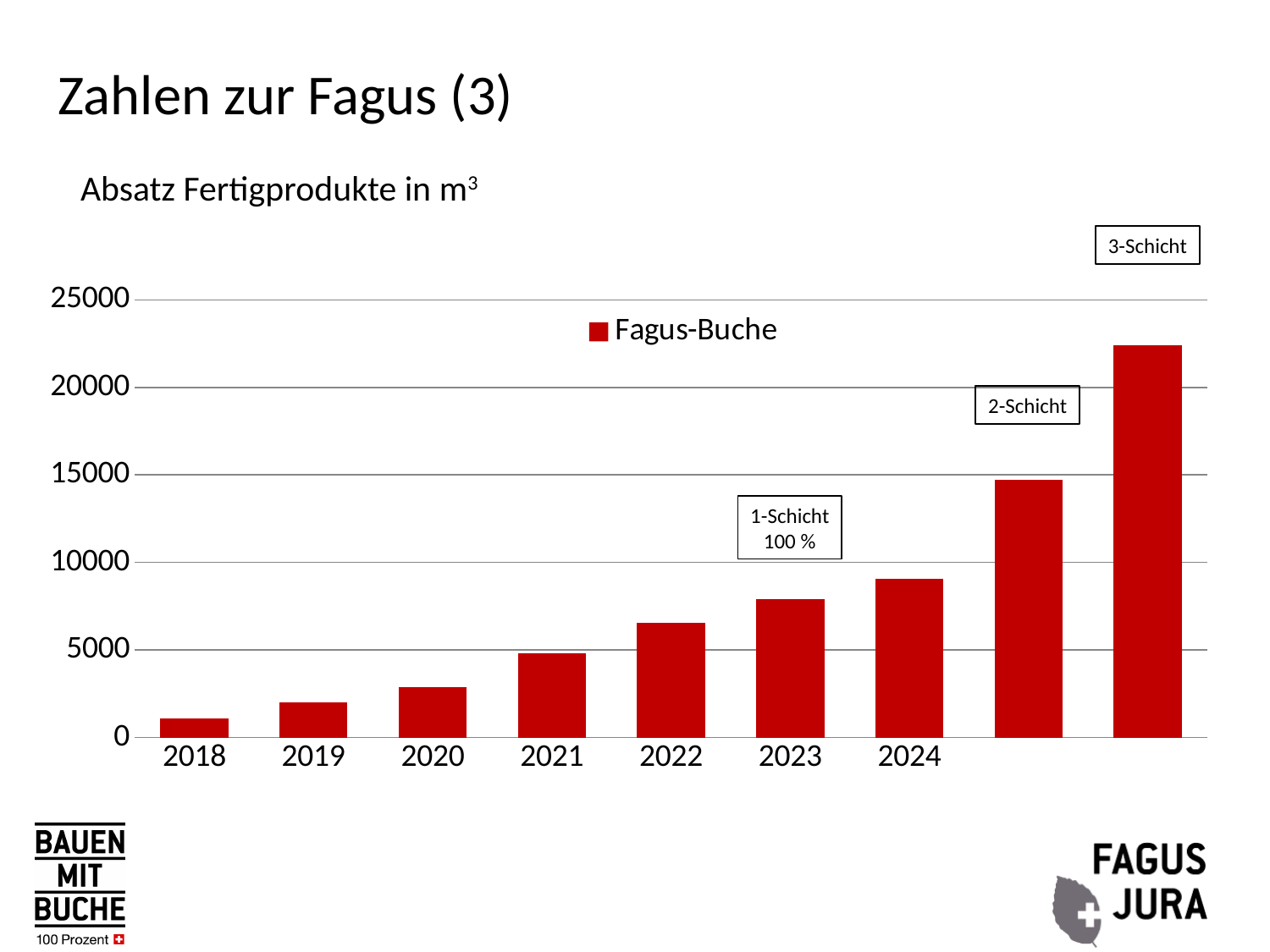
Is the value for 2020 greater or less than 5000? less What is the name of the series shown in the legend? Fagus-Buche Which labeled year has the highest value? 2024 How many series does the legend list? 1 How many bars are plotted in the chart? 9 What unit does the chart subtitle say the sales figures are in? m³ Do the values rise or fall from 2018 to 2024? rise Which is larger, the value for 2021 or the value for 2023? 2023 What kind of chart is shown on the slide? bar chart Is the value for 2024 greater or less than 10000? less Which labeled year has the lowest value? 2018 Is the value for 2022 greater or less than 5000? greater